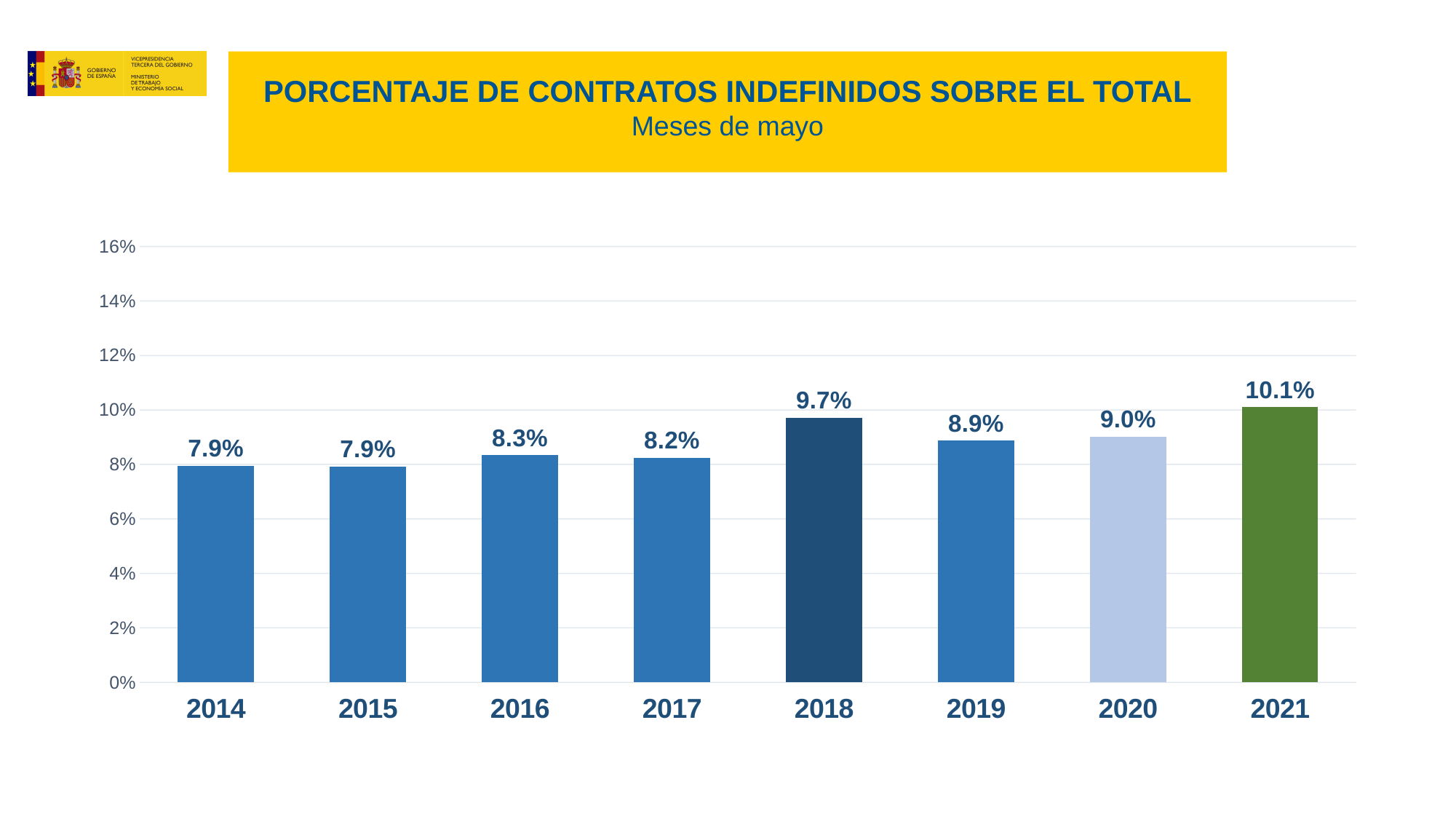
Which year has the highest value? 2021 What is the value for 2018? 9.7% Which is larger, the value for 2017 or the value for 2020? 2020 Which year has the lowest value? 2014 and 2015 What kind of chart is shown on the slide? bar chart What is the value for 2021? 10.1% How many years are shown on the x axis? 8 What is the difference between the values for 2018 and 2019? 0.8% Is the value for 2021 greater or less than 10%? greater What is the difference between the values for 2021 and 2014? 2.2% What is the value for 2016? 8.3% What is the subtitle shown under the chart title? Meses de mayo